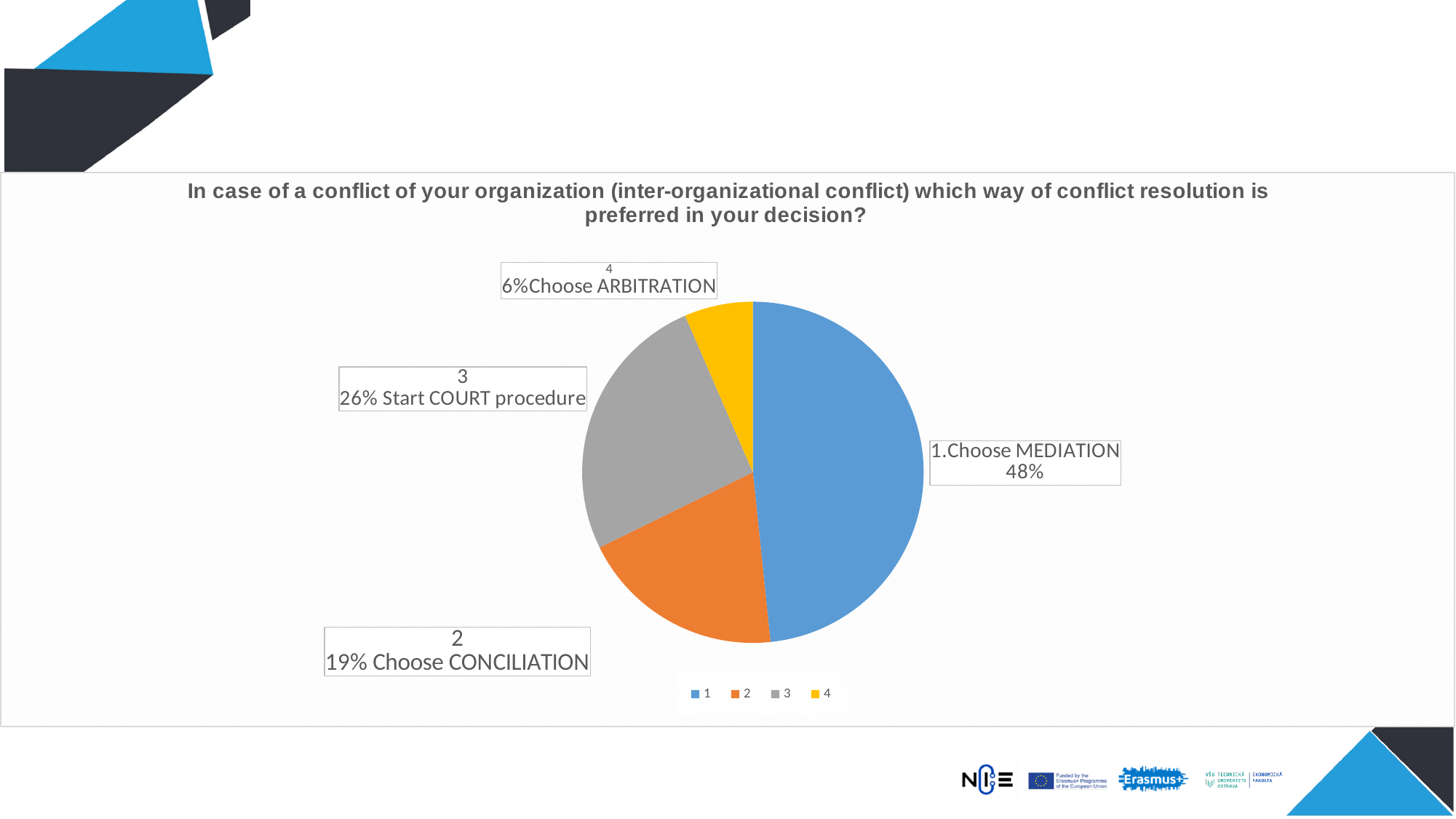
What share of respondents choose MEDIATION? 48% What share of respondents start COURT procedure? 26% Which conflict resolution option has the largest share of the pie? Choose MEDIATION Which conflict resolution option has the smallest share of the pie? Choose ARBITRATION How many slices does the pie chart have? 4 How many percentage points larger is the share for Choose MEDIATION than for Start COURT procedure? 22 How many entries does the legend list? 4 Which has a larger share: Choose CONCILIATION or Start COURT procedure? Start COURT procedure What share of respondents choose CONCILIATION? 19% What share of respondents choose ARBITRATION? 6% What kind of chart is shown on the slide? pie chart What colour is the slice for Choose MEDIATION? blue